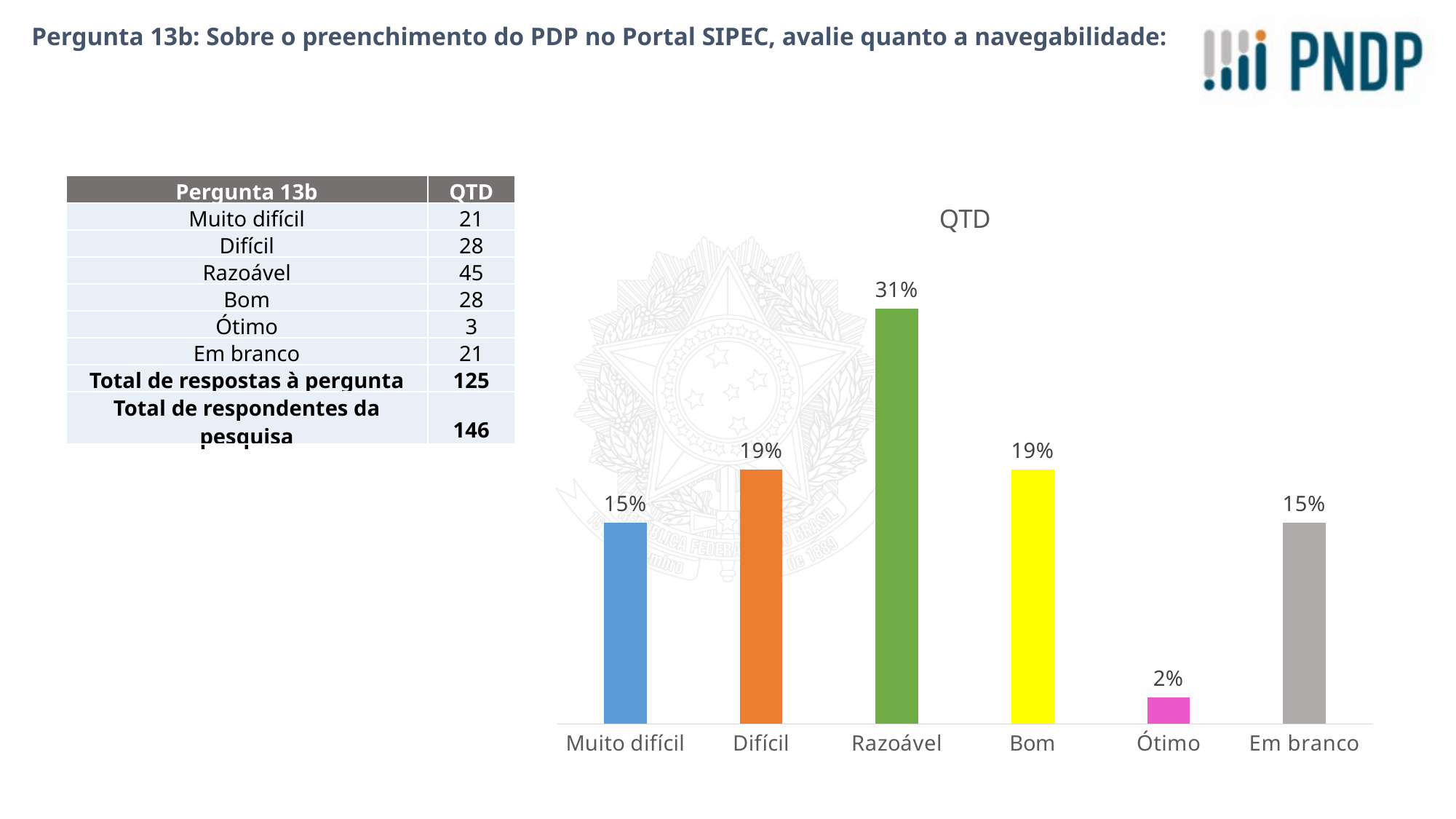
What is the title of the chart? QTD Which category has the lowest bar in the chart? Ótimo What is the data label shown for Em branco in the chart? 15% What kind of chart is shown on the slide? Bar chart What is the data label shown for Ótimo in the chart? 2% What is the difference in percentage points between the labels for Razoável and Bom? 12% Do the labels for Difícil and Bom show the same value? Yes, both 19% What is the data label shown for Razoável in the chart? 31% What colour is the bar for Razoável? Green Which is larger in the chart, the value for Difícil or the value for Muito difícil? Difícil Which category has the highest bar in the chart? Razoável How many categories are shown on the x axis of the chart? 6